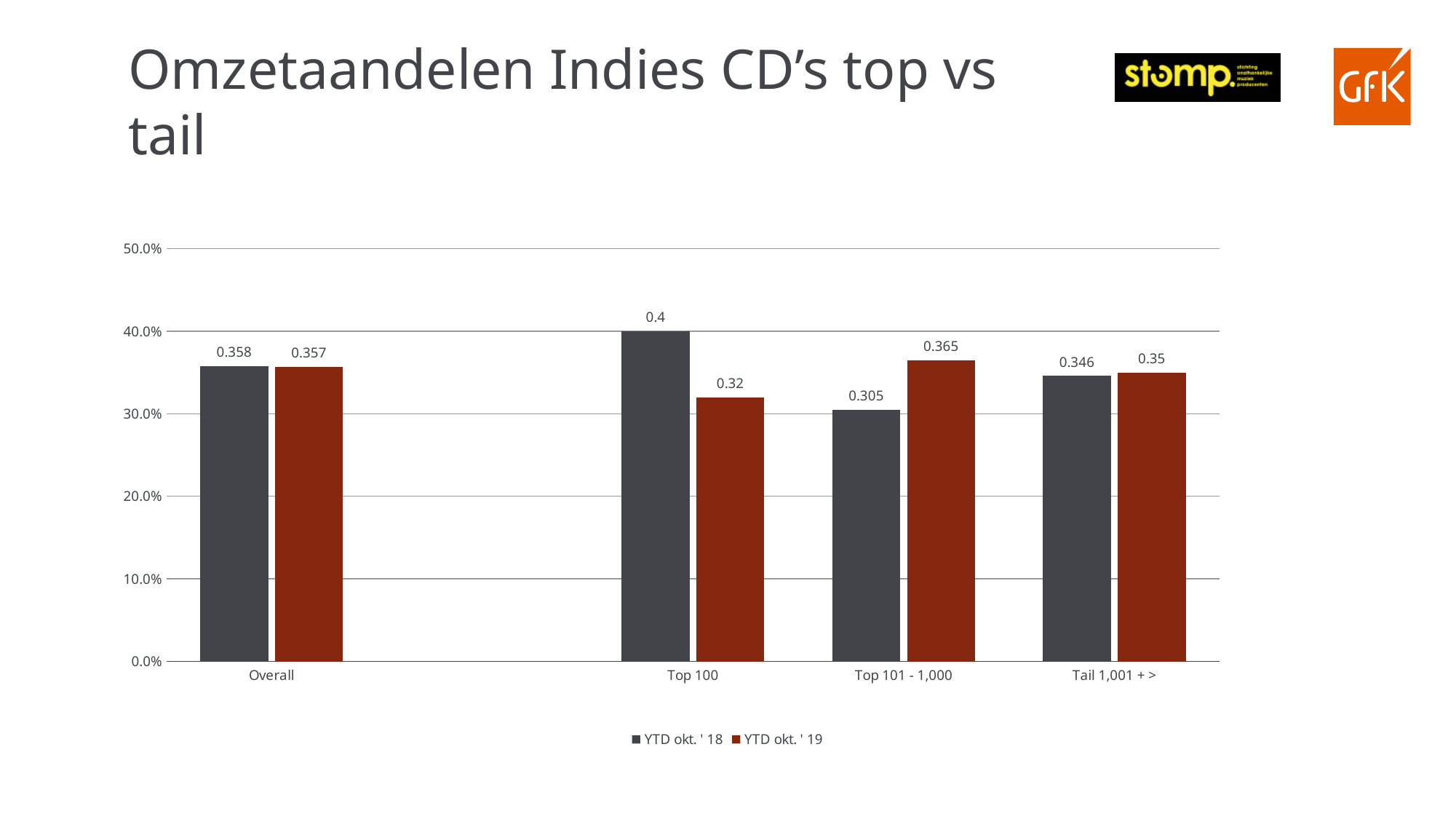
For Top 101 - 1,000, which series has the larger value, YTD okt. ' 18 or YTD okt. ' 19? YTD okt. ' 19 What is the value for Tail 1,001 + > in the YTD okt. ' 18 series? 0.346 Which category has the highest value in the YTD okt. ' 18 series? Top 100 Which category has the lowest value in the YTD okt. ' 19 series? Top 100 How many categories are shown on the x axis? 4 How many series does the legend list? 2 What is the difference between the YTD okt. ' 18 and YTD okt. ' 19 values for Top 100? 0.08 What is the value for Top 100 in the YTD okt. ' 18 series? 0.4 What kind of chart is shown on the slide? Bar chart What is the value for Top 101 - 1,000 in the YTD okt. ' 19 series? 0.365 What is the value for Overall in the YTD okt. ' 19 series? 0.357 What colour are the bars for the YTD okt. ' 19 series? Dark red